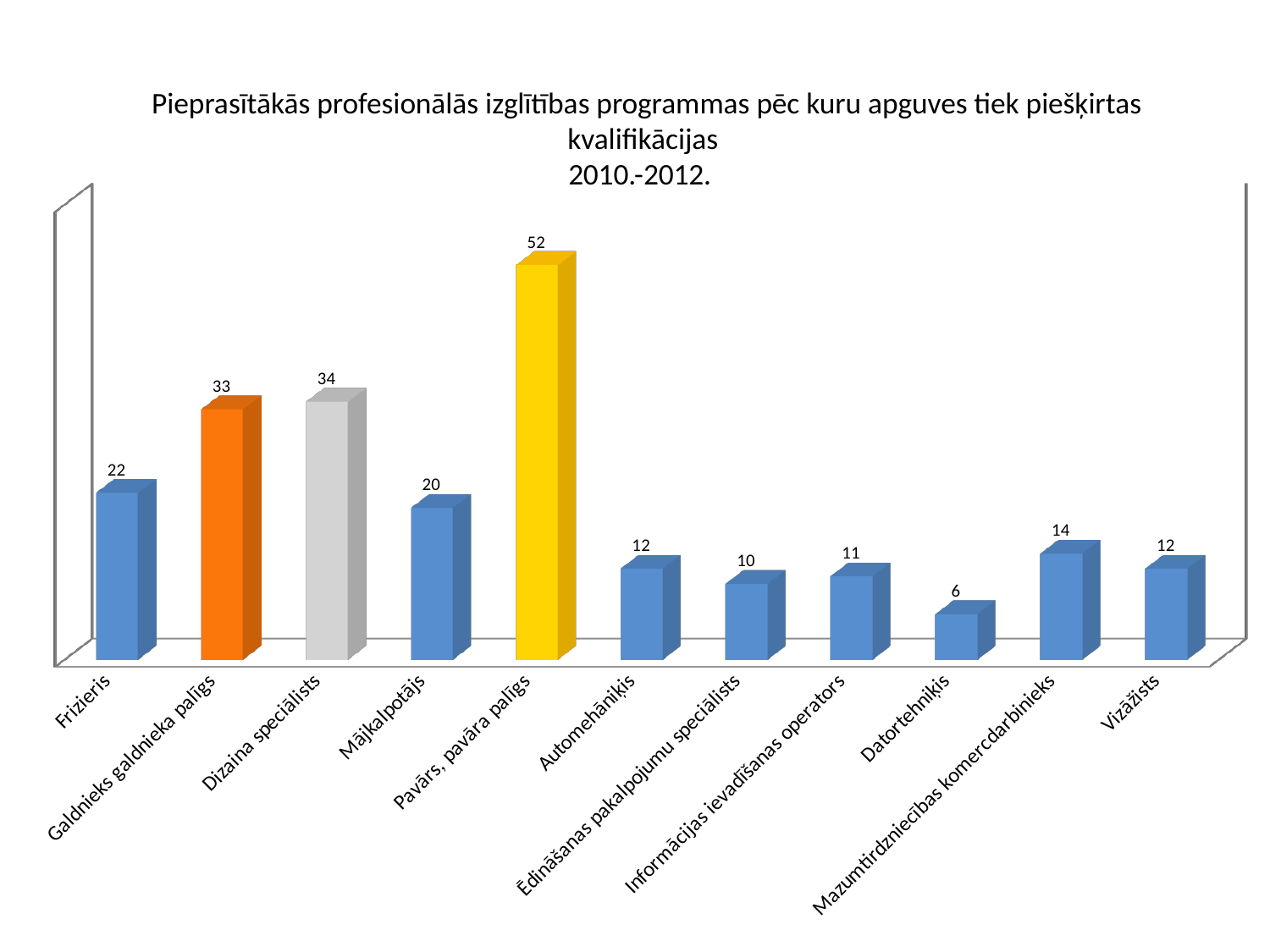
How many categories are shown on the x axis? 11 What is the value for Frizieris? 22 What is the difference between the values for Frizieris and Mājkalpotājs? 2 Which category has the highest value? Pavārs, pavāra palīgs What is the value for Pavārs, pavāra palīgs? 52 What is the value for Datortehniķis? 6 What colour is the bar for Pavārs, pavāra palīgs? Yellow What kind of chart is shown on the slide? Bar chart What is the value for Mazumtirdzniecības komercdarbinieks? 14 What is the difference between the values for Pavārs, pavāra palīgs and Dizaina speciālists? 18 Which is larger, the value for Galdnieks galdnieka palīgs or the value for Mājkalpotājs? Galdnieks galdnieka palīgs Which category has the lowest value? Datortehniķis